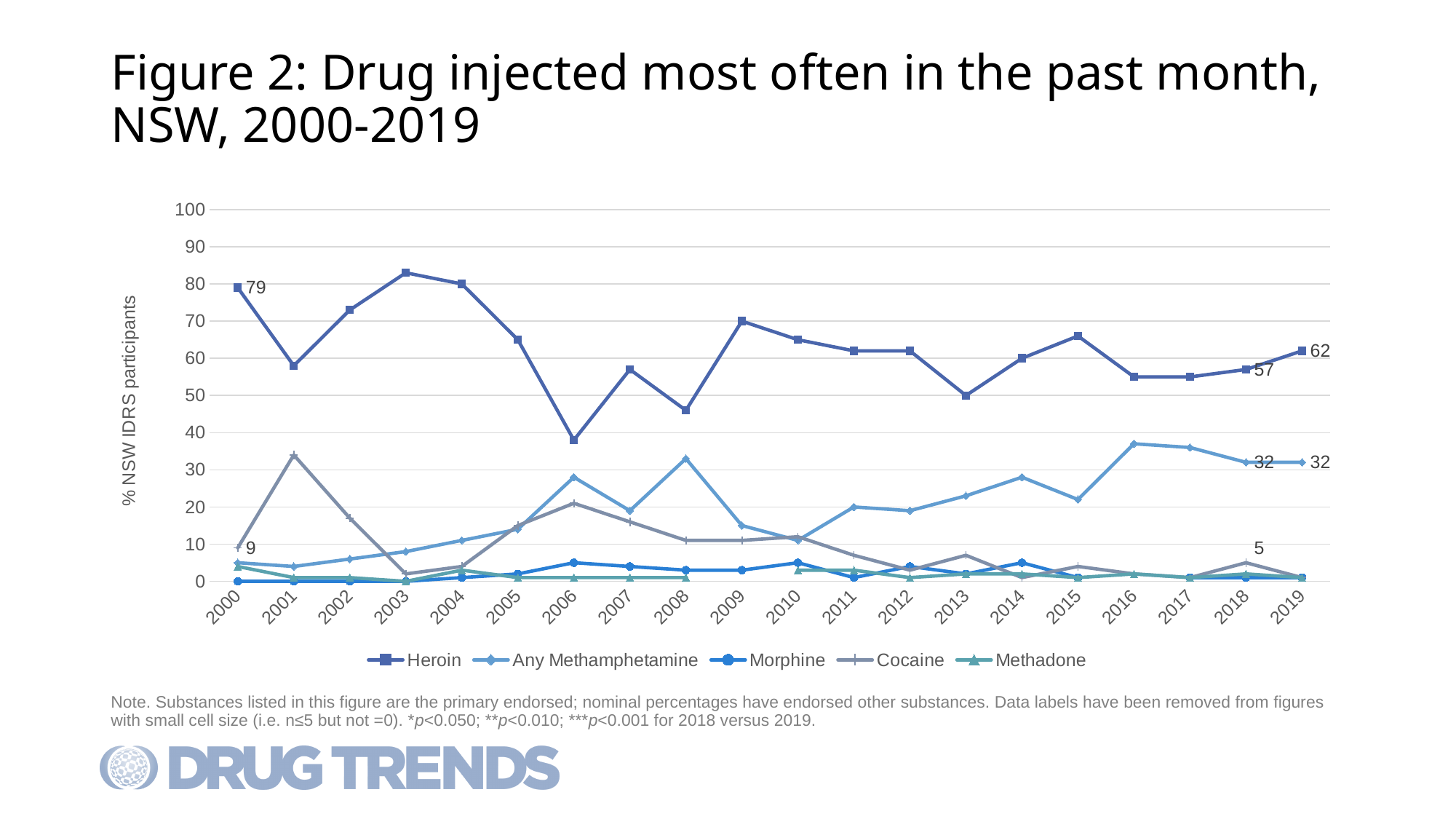
How many years are shown on the x axis? 20 What is the difference between the Heroin value in 2000 and in 2019? 17 What is the value for Heroin in 2000? 79 What is the value for Cocaine in 2000? 9 How many series does the legend list? 5 What is the value for Any Methamphetamine in 2019? 32 What is the value for Heroin in 2019? 62 Is the value for Heroin in 2003 greater or less than 80? greater Which series has the highest value in 2019? Heroin What kind of chart is shown on the slide? Line chart By how much did the Heroin value increase from 2018 to 2019? 5 In 2018, which is larger: the value for Heroin or the value for Any Methamphetamine? Heroin